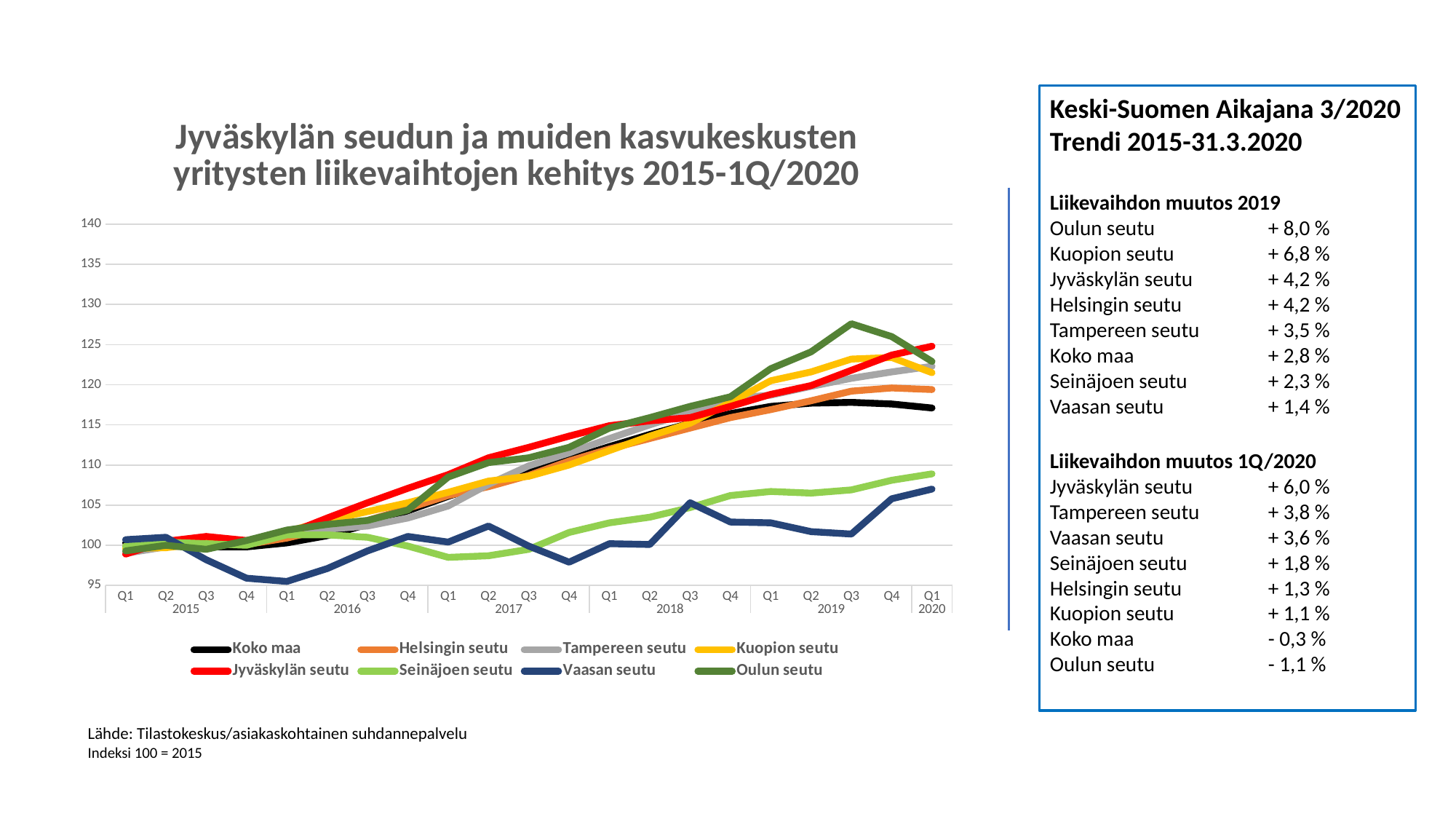
What colour is the Jyväskylän seutu line in the chart? red Is the value for Jyväskylän seutu in Q1 2020 greater or less than 120? greater Which series has the highest value in Q3 2019? Oulun seutu Is the value for Seinäjoen seutu in Q1 2020 greater or less than 115? less Is the value for Oulun seutu in Q3 2019 greater or less than 125? greater Does the Jyväskylän seutu line rise or fall from Q1 2015 to Q1 2020? rise In Q1 2020, which is higher: Oulun seutu or Vaasan seutu? Oulun seutu How many series does the chart legend list? 8 What kind of chart is shown on the slide? line chart Which series has the lowest value in Q1 2016? Vaasan seutu How many quarterly points are plotted along the x axis of the chart? 21